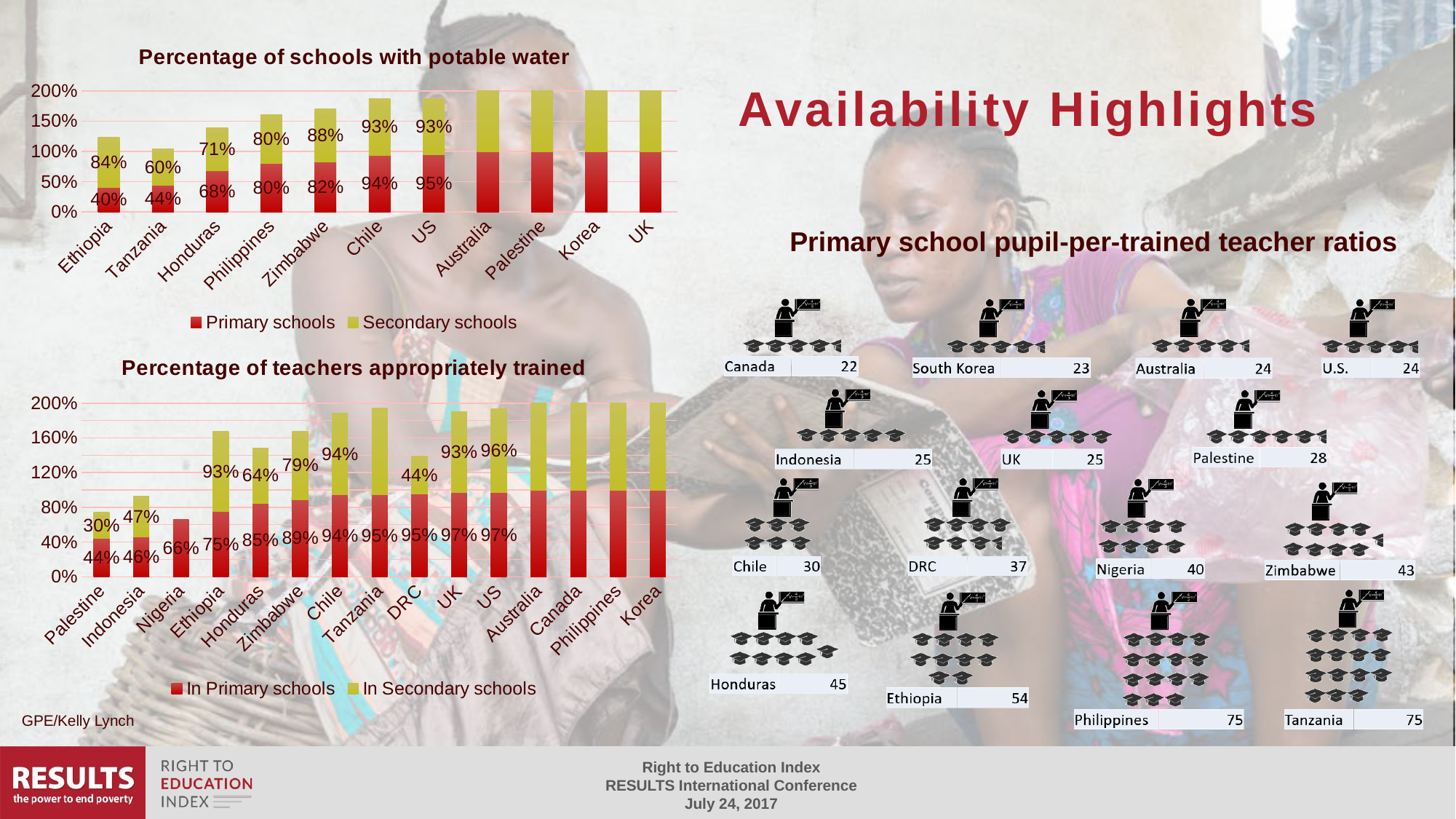
In the 'Percentage of schools with potable water' chart, what is the value for Primary schools in Ethiopia? 40% In the 'Percentage of schools with potable water' chart, how many countries are shown on the x axis? 11 In the 'Percentage of schools with potable water' chart, what is the difference between the Secondary schools and Primary schools values for Ethiopia? 44% In the 'Primary school pupil-per-trained teacher ratios' chart, what is the difference between the ratios for Tanzania and Chile? 45 In the 'Primary school pupil-per-trained teacher ratios' chart, which country has the lowest ratio? Canada In the 'Percentage of teachers appropriately trained' chart, how many series does the legend list? 2 What kind of chart is 'Percentage of teachers appropriately trained'? Stacked bar chart In the 'Percentage of schools with potable water' chart, what is the total of the stacked bar for Zimbabwe? 170% In the 'Primary school pupil-per-trained teacher ratios' chart, what is the ratio for Ethiopia? 54 In the 'Percentage of teachers appropriately trained' chart, which is larger for Honduras: In Primary schools or In Secondary schools? In Primary schools In the 'Percentage of teachers appropriately trained' chart, what is the value for In Secondary schools in DRC? 44% In the 'Percentage of schools with potable water' chart, what is the value for Secondary schools in Tanzania? 60%